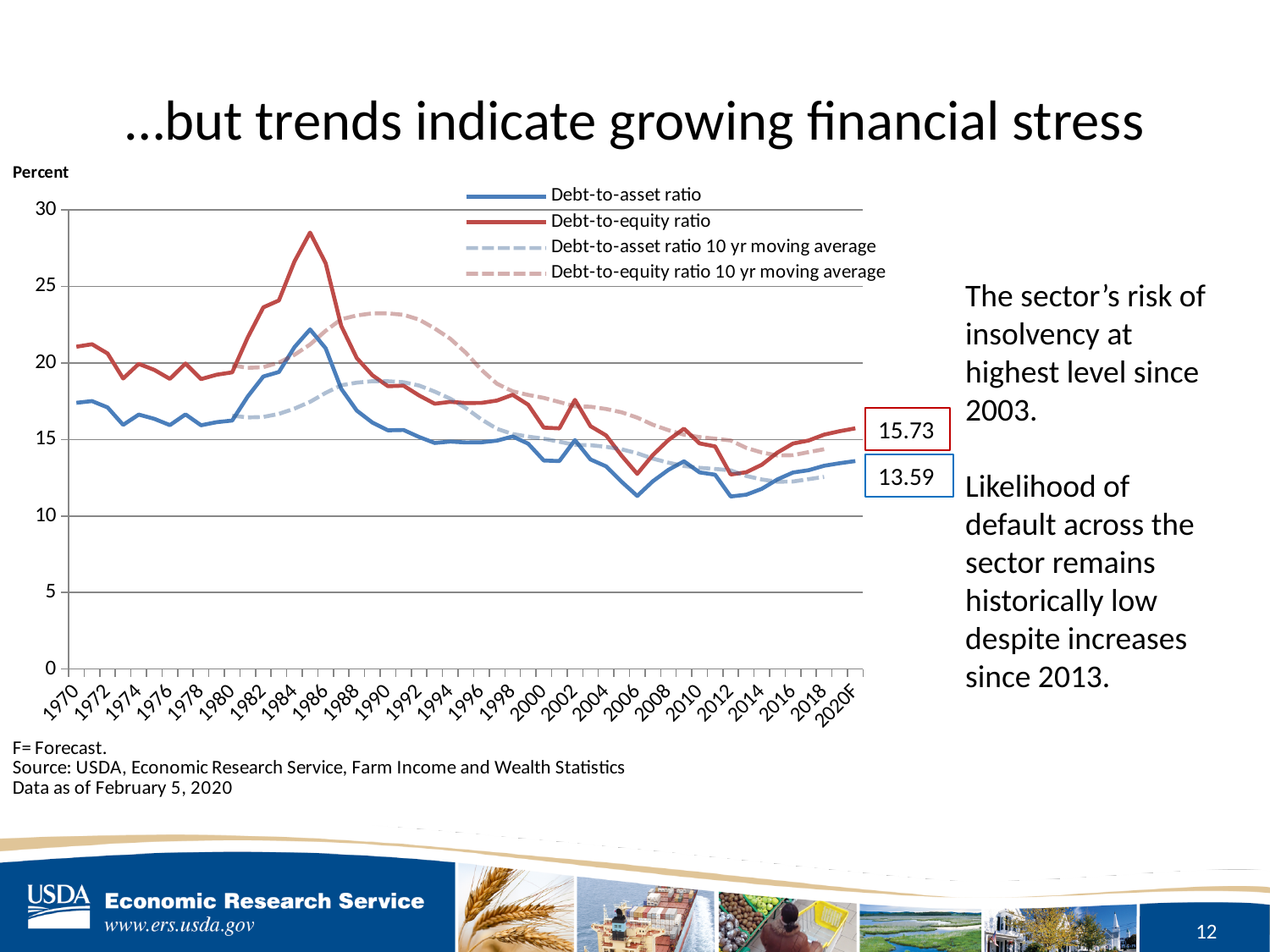
Is the debt-to-equity ratio in 1985 greater or less than 25? greater Does the debt-to-asset ratio rise or fall from 2013 to 2020F? rise What unit is shown on the vertical axis label of the chart? Percent In which year does the debt-to-equity ratio reach its highest point? 1985 Is the debt-to-asset ratio in 2006 greater or less than 15? less What kind of chart is shown on the slide? line chart What is the labeled value of the debt-to-equity ratio for 2020F? 15.73 What is the labeled value of the debt-to-asset ratio for 2020F? 13.59 How many series does the chart legend list? 4 Which series reaches the highest value on the chart? Debt-to-equity ratio What is the difference between the 2020F debt-to-equity ratio (15.73) and the 2020F debt-to-asset ratio (13.59)? 2.14 In 2020F, which is larger: the debt-to-equity ratio or the debt-to-asset ratio? Debt-to-equity ratio